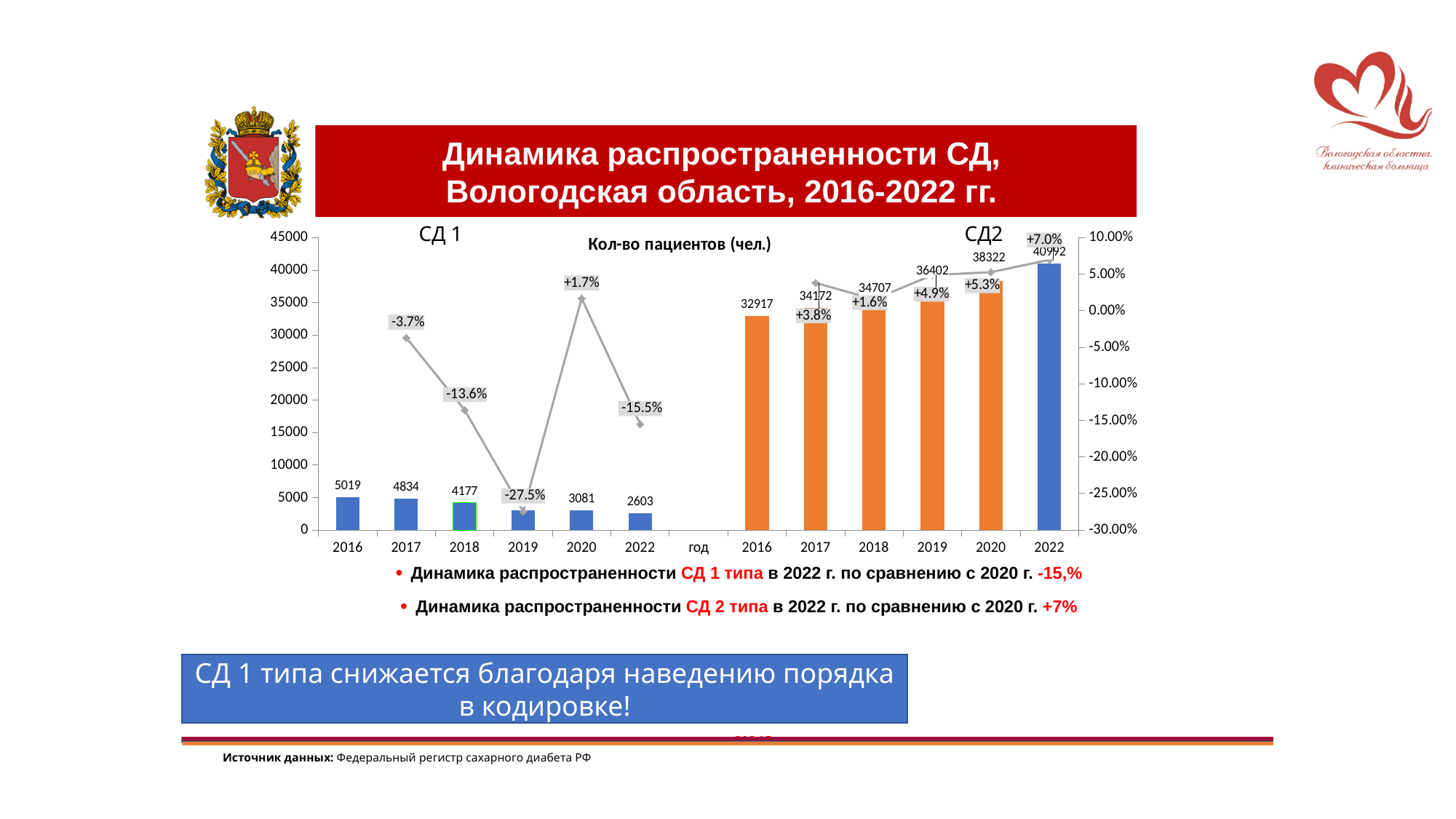
What percentage change is shown for СД 1 in 2019? -27.5% What is the number of patients for СД2 in 2020? 38322 Do the СД2 patient numbers rise or fall from 2016 to 2022? rise What is the title of the slide's chart section? Динамика распространенности СД, Вологодская область, 2016-2022 гг. What is the number of patients for СД 1 in 2016? 5019 What is the difference between the number of СД2 patients in 2020 and in 2016? 5405 In which year is the number of СД 1 patients lowest? 2022 What percentage change is shown for СД2 in 2022? +7.0% Is the number of СД2 patients in 2016 greater or less than 30000? greater Which year has more СД2 patients, 2018 or 2019? 2019 By how much did the number of СД 1 patients fall from 2016 to 2017? 185 In which year is the number of СД 1 patients highest? 2016